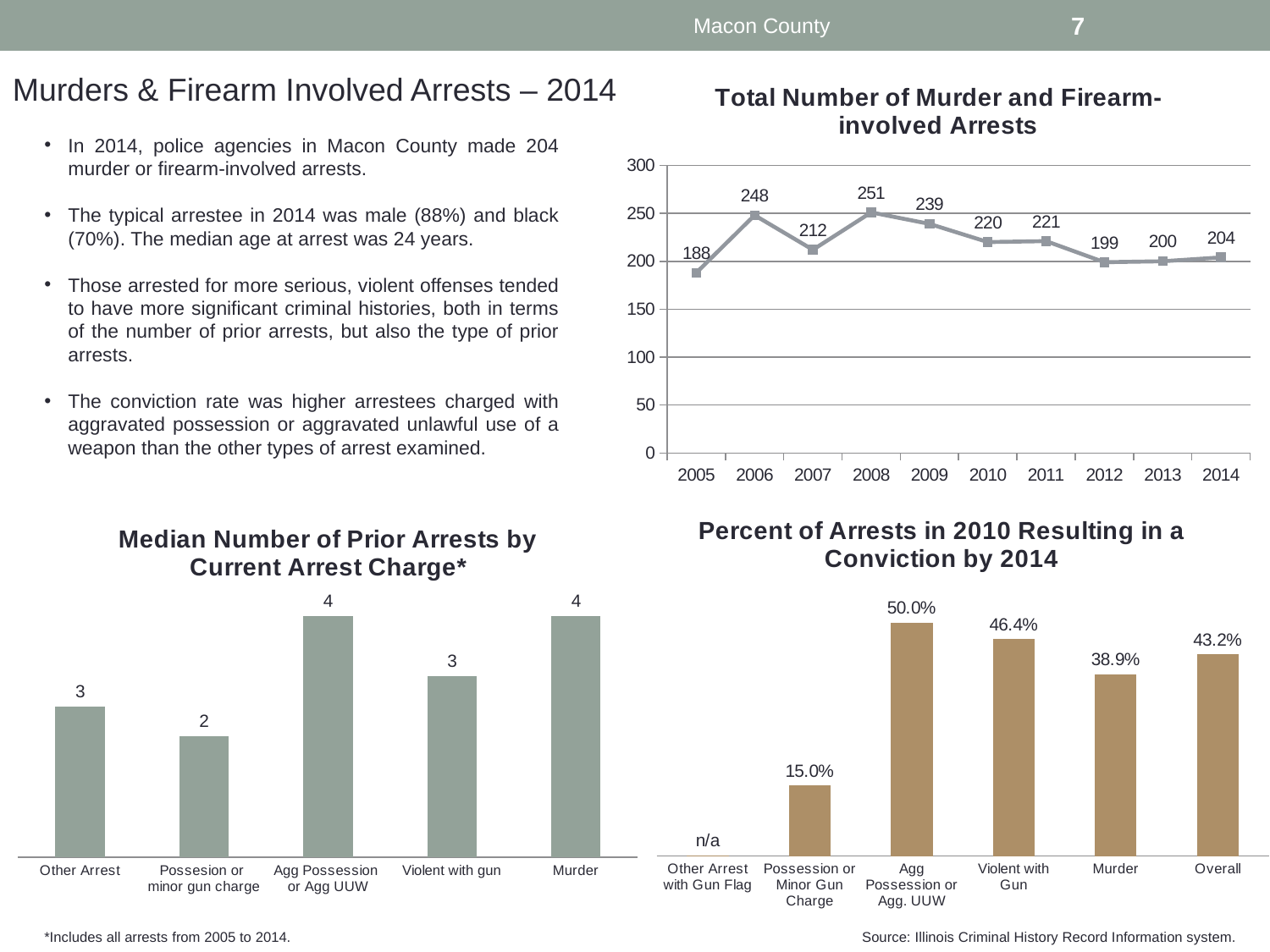
In the 'Total Number of Murder and Firearm-involved Arrests' chart, do the values rise or fall from 2009 to 2012? Fall In the 'Total Number of Murder and Firearm-involved Arrests' chart, what is the value for 2008? 251 In the 'Percent of Arrests in 2010 Resulting in a Conviction by 2014' chart, which is larger: Violent with Gun or Overall? Violent with Gun In the 'Total Number of Murder and Firearm-involved Arrests' chart, which year has the lowest value? 2005 In the 'Percent of Arrests in 2010 Resulting in a Conviction by 2014' chart, which category has the highest value? Agg Possession or Agg. UUW What kind of chart is 'Median Number of Prior Arrests by Current Arrest Charge*'? Bar chart In the 'Percent of Arrests in 2010 Resulting in a Conviction by 2014' chart, what is the value for Murder? 38.9% In the 'Median Number of Prior Arrests by Current Arrest Charge*' chart, which category has the lowest value? Possesion or minor gun charge In the 'Median Number of Prior Arrests by Current Arrest Charge*' chart, what is the value for Violent with gun? 3 In the 'Total Number of Murder and Firearm-involved Arrests' chart, how many years are plotted? 10 What kind of chart is 'Total Number of Murder and Firearm-involved Arrests'? Line chart In the 'Total Number of Murder and Firearm-involved Arrests' chart, what is the difference between the 2006 and 2007 values? 36